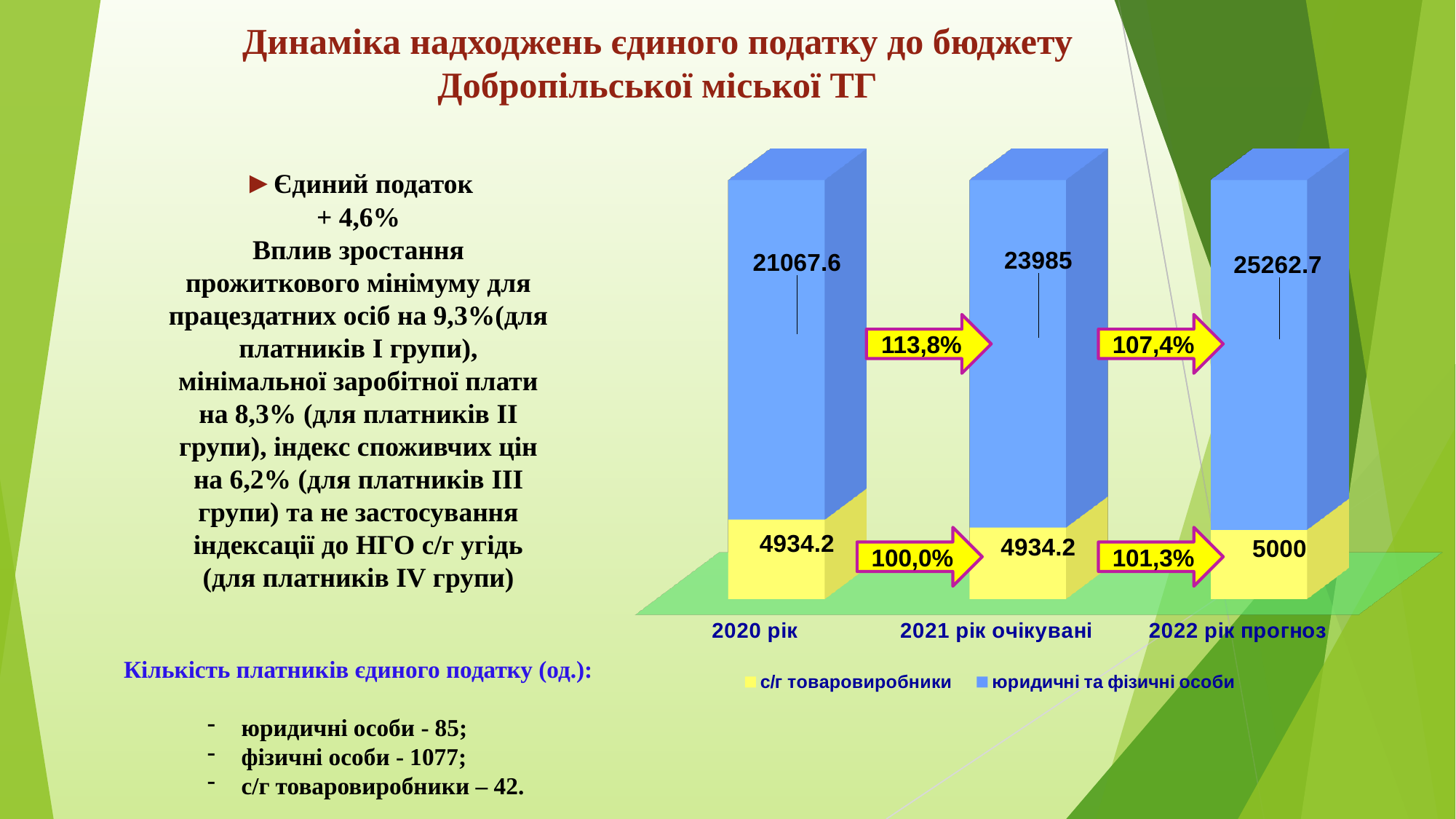
Which is larger: the с/г товаровиробники value for 2022 рік прогноз or for 2021 рік очікувані? 2022 рік прогноз Which year has the lowest value for юридичні та фізичні особи? 2020 рік What is the difference between the юридичні та фізичні особи values for 2021 рік очікувані and 2020 рік? 2917.4 What kind of chart is shown on the slide? Stacked bar chart How many series does the chart legend list? 2 What is the value for юридичні та фізичні особи in 2020 рік? 21067.6 How many years (categories) are shown on the x axis of the chart? 3 What is the total of the stacked bar for 2022 рік прогноз? 30262.7 Which year has the highest value for юридичні та фізичні особи? 2022 рік прогноз What is the value for юридичні та фізичні особи in 2021 рік очікувані? 23985 What is the value for с/г товаровиробники in 2022 рік прогноз? 5000 What is the difference between the юридичні та фізичні особи values for 2022 рік прогноз and 2021 рік очікувані? 1277.7